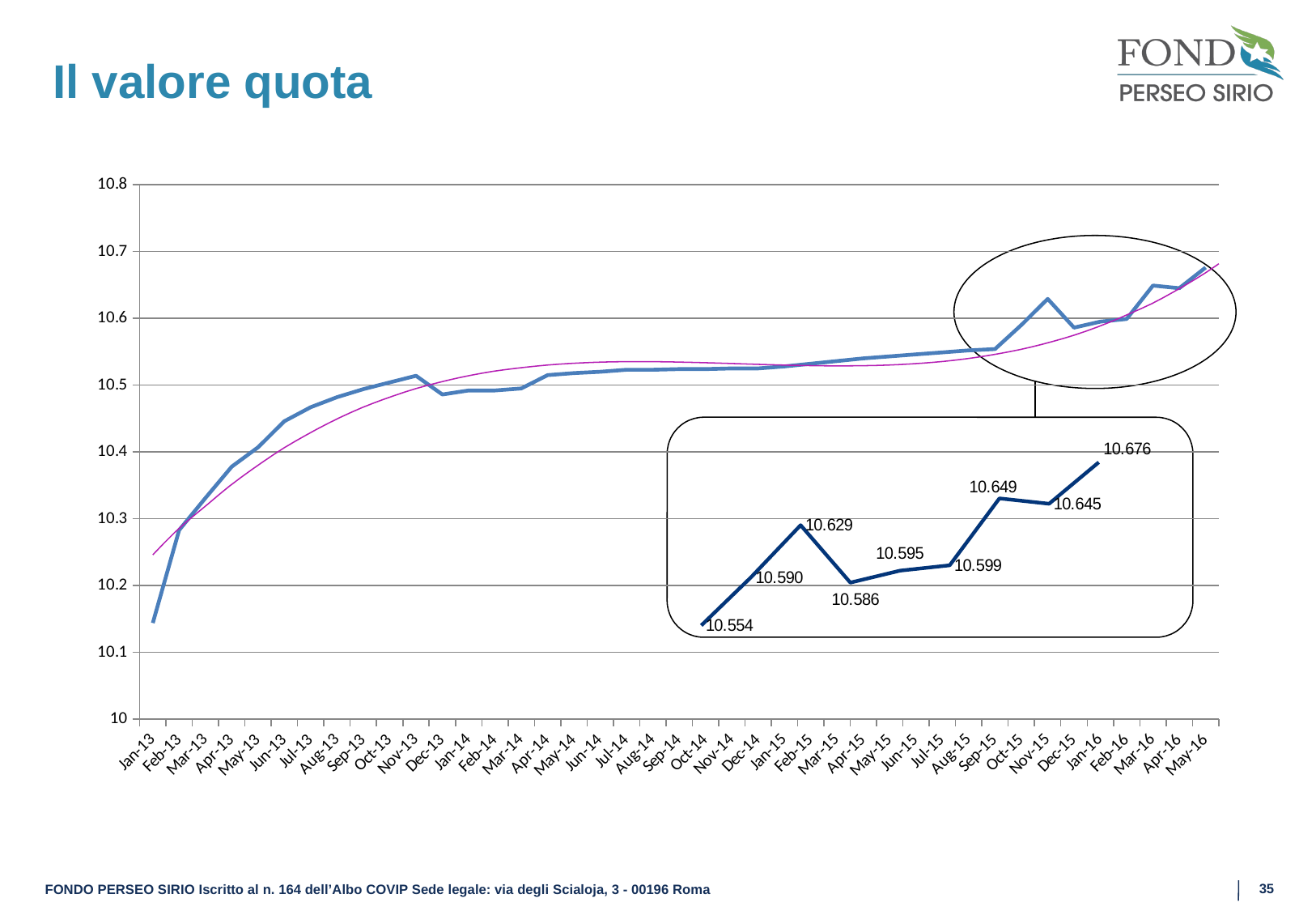
What is the value labelled at the last point of the zoomed inset? 10.676 What is the difference between the highest and lowest labelled values in the inset (10.676 and 10.554)? 0.122 Which labelled value in the inset is larger, 10.629 or 10.586? 10.629 How many data points are labelled with values in the zoomed inset? 9 Is the value for Jan-13 on the main chart greater or less than 10.2? less What is the lowest value labelled in the zoomed inset box? 10.554 Is the value for Jun-13 on the main chart greater or less than 10.4? greater What is the title of the slide containing the chart? Il valore quota What is the value labelled at the first point of the zoomed inset? 10.554 Overall, does the blue line rise or fall from Jan-13 to May-16? rise What is the highest value labelled in the zoomed inset box? 10.676 What kind of chart is shown on the slide? line chart